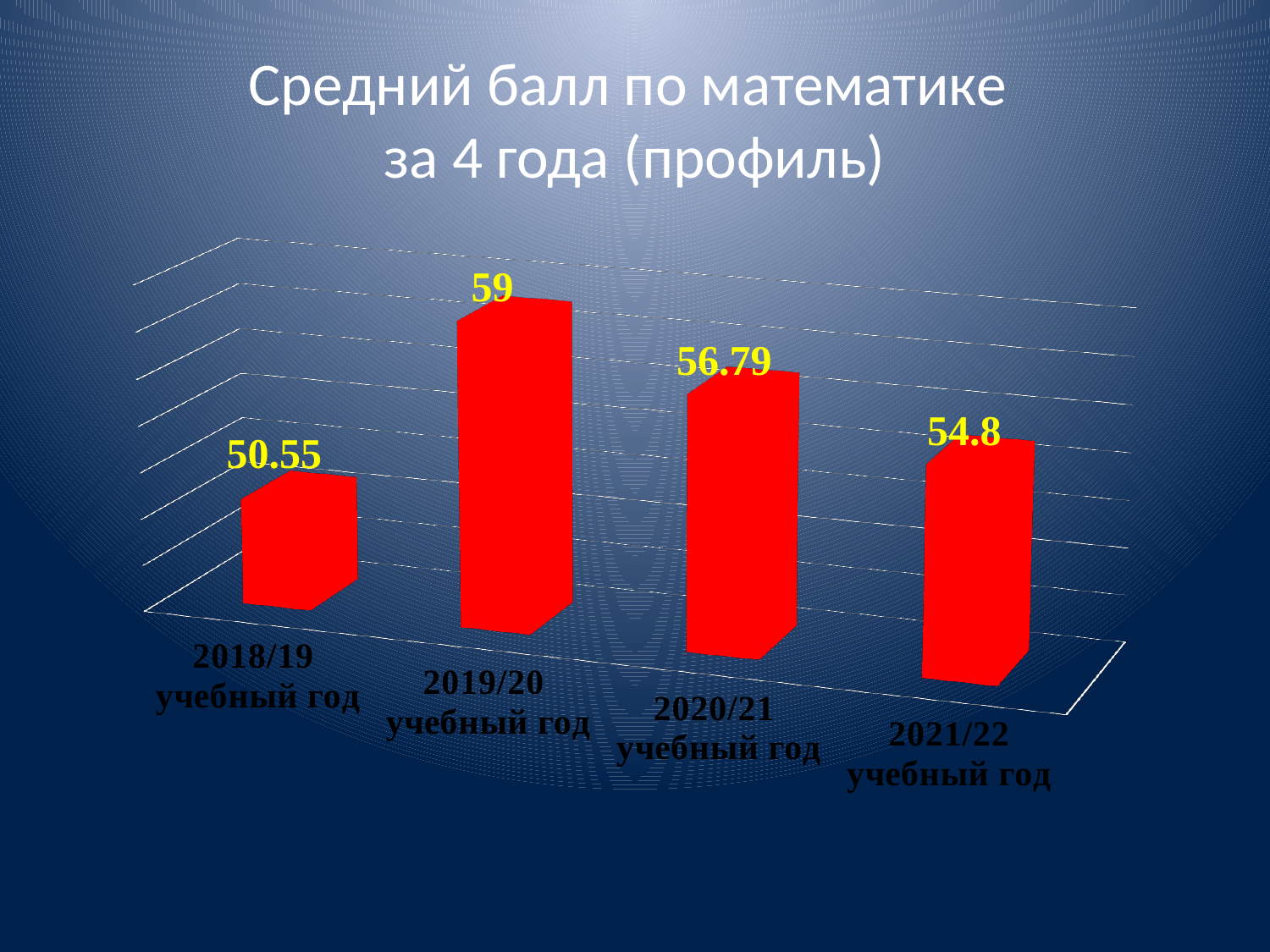
How many academic years are shown in the chart? 4 Which is larger, the average score for 2020/21 or for 2021/22? 2020/21 учебный год What is the title of the chart? Средний балл по математике за 4 года (профиль) What is the difference between the average scores for 2020/21 and 2021/22? 1.99 What is the difference between the average scores for 2019/20 and 2018/19? 8.45 What type of chart is shown on the slide? Bar chart Which academic year has the lowest average math score? 2018/19 учебный год Which academic year has the highest average math score? 2019/20 учебный год What is the average math score for the 2021/22 учебный год? 54.8 What is the average math score for the 2020/21 учебный год? 56.79 What is the average math score for the 2018/19 учебный год? 50.55 What is the average math score for the 2019/20 учебный год? 59